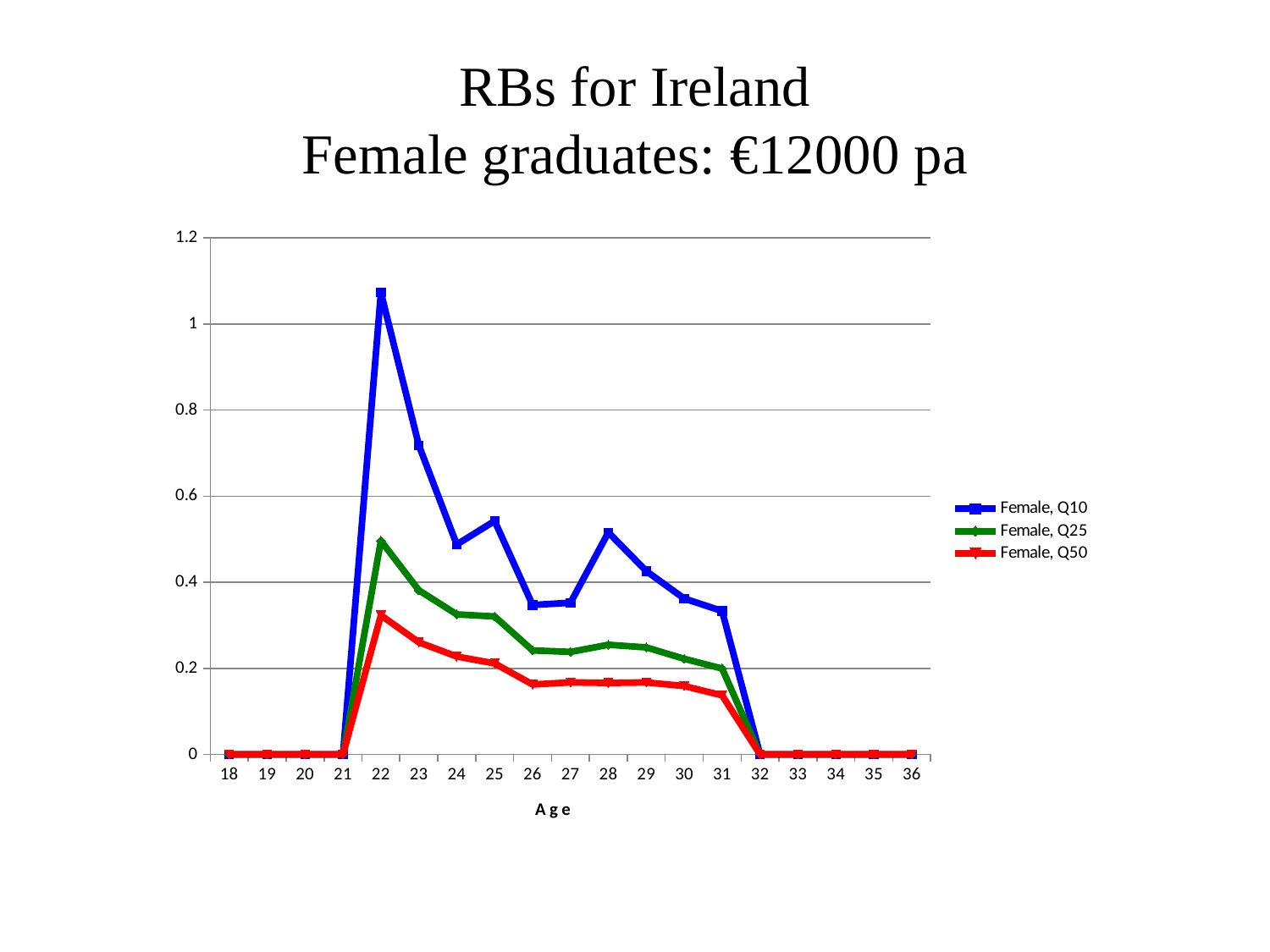
At which age does the Female, Q50 series reach its highest value? 22 Is the value for Female, Q10 at age 23 greater or less than 0.6? greater At age 22, which is larger: Female, Q10 or Female, Q50? Female, Q10 How many series does the legend list? 3 Is the value for Female, Q25 at age 26 greater or less than 0.4? less How many age points are shown along the x axis? 19 What is the title of the x axis? Age Is the value for Female, Q10 at age 22 greater or less than 1? greater What is the value for Female, Q10 at age 18? 0 What kind of chart is shown on the slide? line chart At which age does the Female, Q10 series reach its highest value? 22